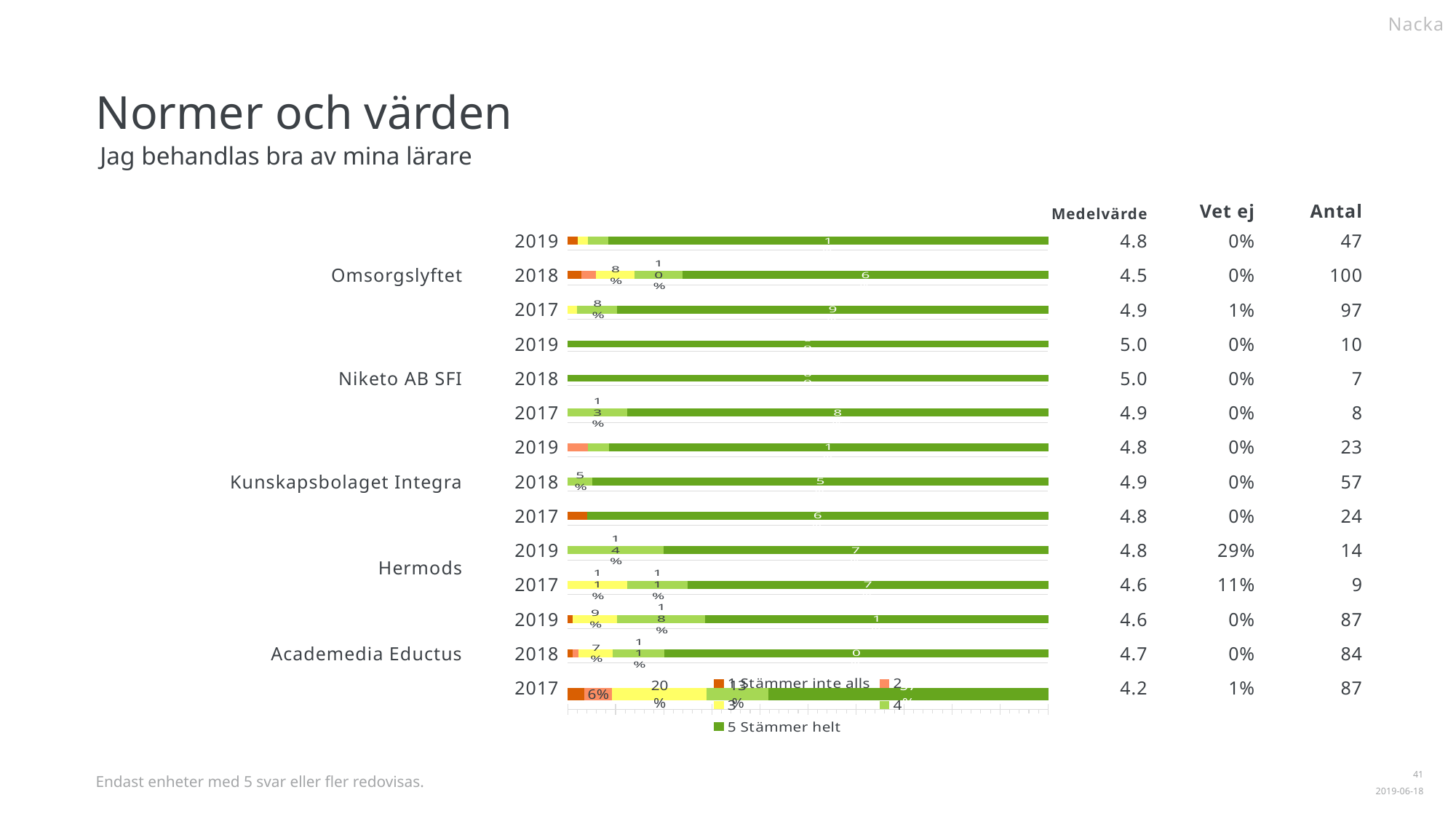
What is the Vet ej value shown for Hermods 2019? 29% What kind of chart is shown on the slide? stacked bar chart How many units (schools) are shown in the chart? 5 What is the first legend entry of the chart? 1 Stämmer inte alls Which unit and year has the lowest Medelvärde shown next to the chart? Academedia Eductus 2017 (4.2) What is the last legend entry of the chart? 5 Stämmer helt What is the Antal shown for Omsorgslyftet 2018? 100 How many series does the chart legend list? 5 What is the value of the yellow '3' segment for Academedia Eductus in 2017? 20% Which has a larger share of '5 Stämmer helt': Niketo AB SFI 2019 or Academedia Eductus 2017? Niketo AB SFI 2019 How many bars are plotted in the chart? 14